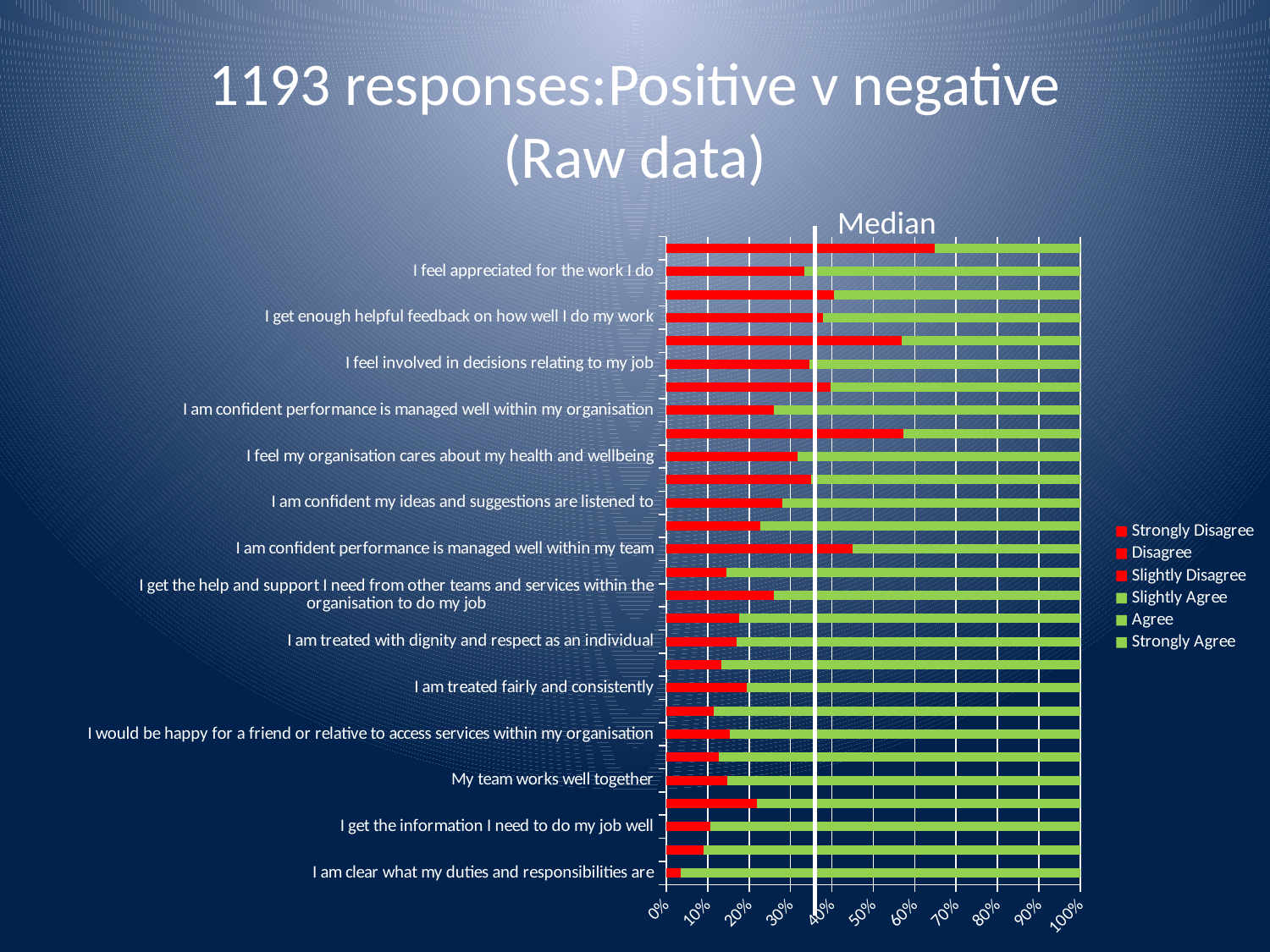
What is the highest value shown on the horizontal axis? 100% Is the red (disagree) portion of the bar for 'I am clear what my duties and responsibilities are' greater or less than 10%? less Is the red (disagree) portion of the bar for 'I feel appreciated for the work I do' greater or less than 20%? greater How many series does the legend list? 6 What label is written above the vertical line drawn through the chart? Median Which has the larger red (disagree) portion: 'I feel appreciated for the work I do' or 'I am clear what my duties and responsibilities are'? I feel appreciated for the work I do Is the red (disagree) portion of the bar for 'I feel involved in decisions relating to my job' greater or less than 20%? greater What kind of chart is shown on the slide? bar chart What is the title of the slide? 1193 responses:Positive v negative (Raw data)